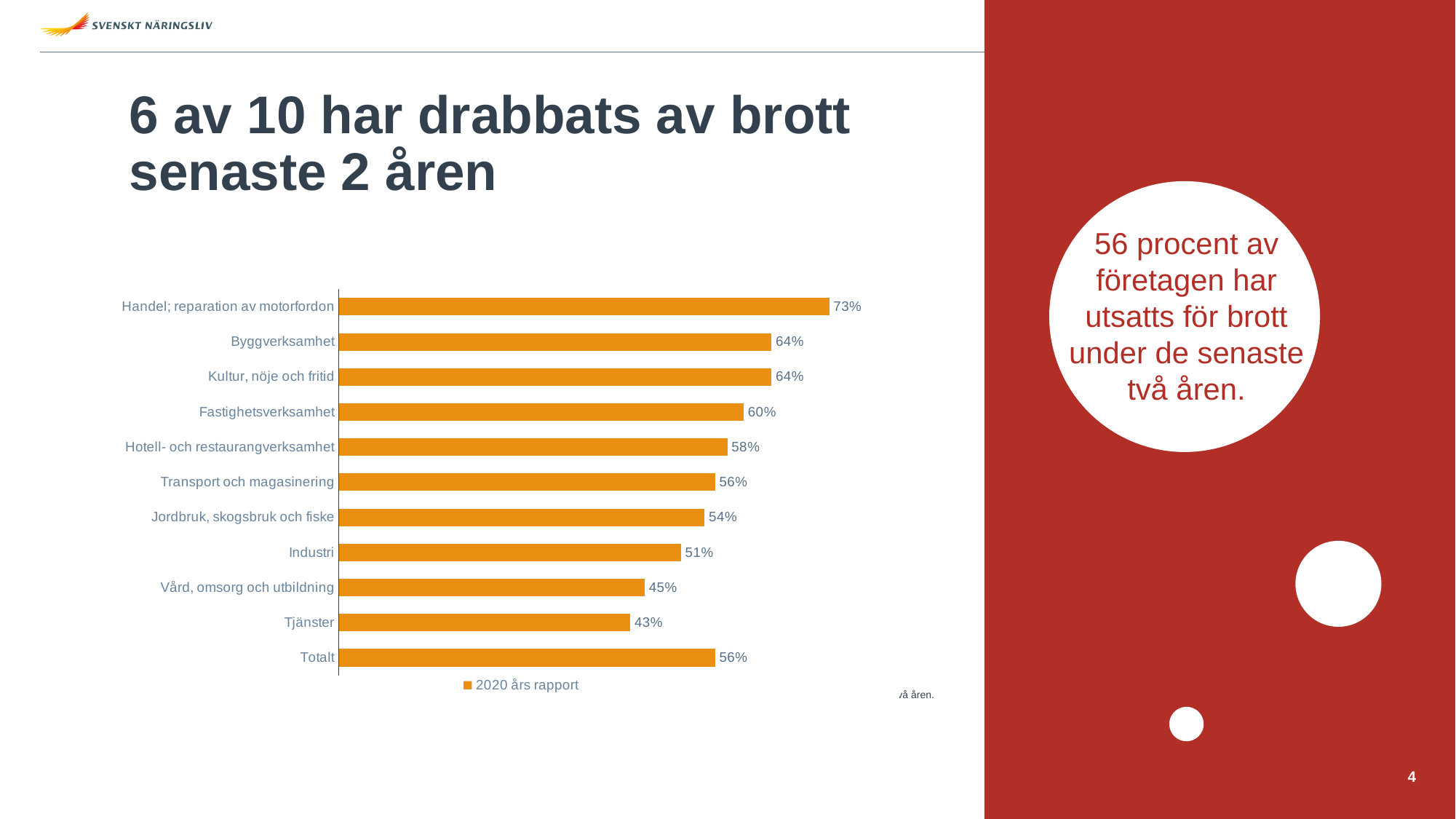
How many series does the legend list? 1 Which category has the highest value? Handel; reparation av motorfordon What is the value for Handel; reparation av motorfordon? 73% What kind of chart is shown on the slide? Bar chart What is the value for Tjänster? 43% What is the difference between the values for Handel; reparation av motorfordon and Tjänster? 30% What is the value for Totalt? 56% What is the value for Vård, omsorg och utbildning? 45% Which is larger, the value for Byggverksamhet or the value for Hotell- och restaurangverksamhet? Byggverksamhet How many categories are shown in the chart? 11 What is the difference between the values for Fastighetsverksamhet and Industri? 9% Which category has the lowest value? Tjänster